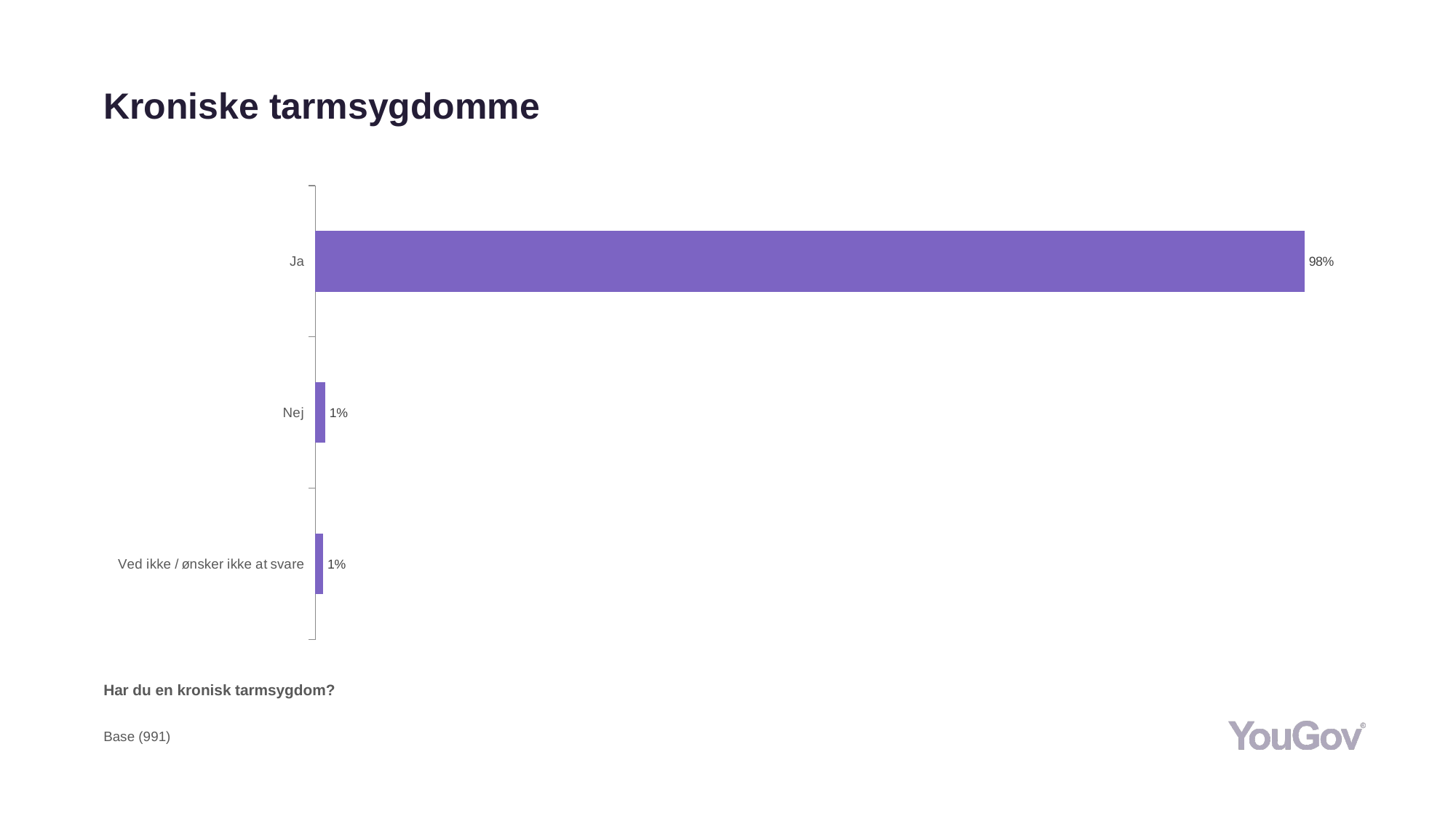
What is the value for "Nej"? 1% What kind of chart is shown on the slide? Bar chart How many categories are shown in the chart? 3 What is the value for "Ja"? 98% What is the value for "Ved ikke / ønsker ikke at svare"? 1% What is the difference between the values for "Ja" and "Nej"? 97% What is the base (number of respondents) shown on the slide? 991 What is the title of the slide? Kroniske tarmsygdomme Which is larger, the value for "Ja" or the value for "Ved ikke / ønsker ikke at svare"? Ja Which category has the highest value? Ja